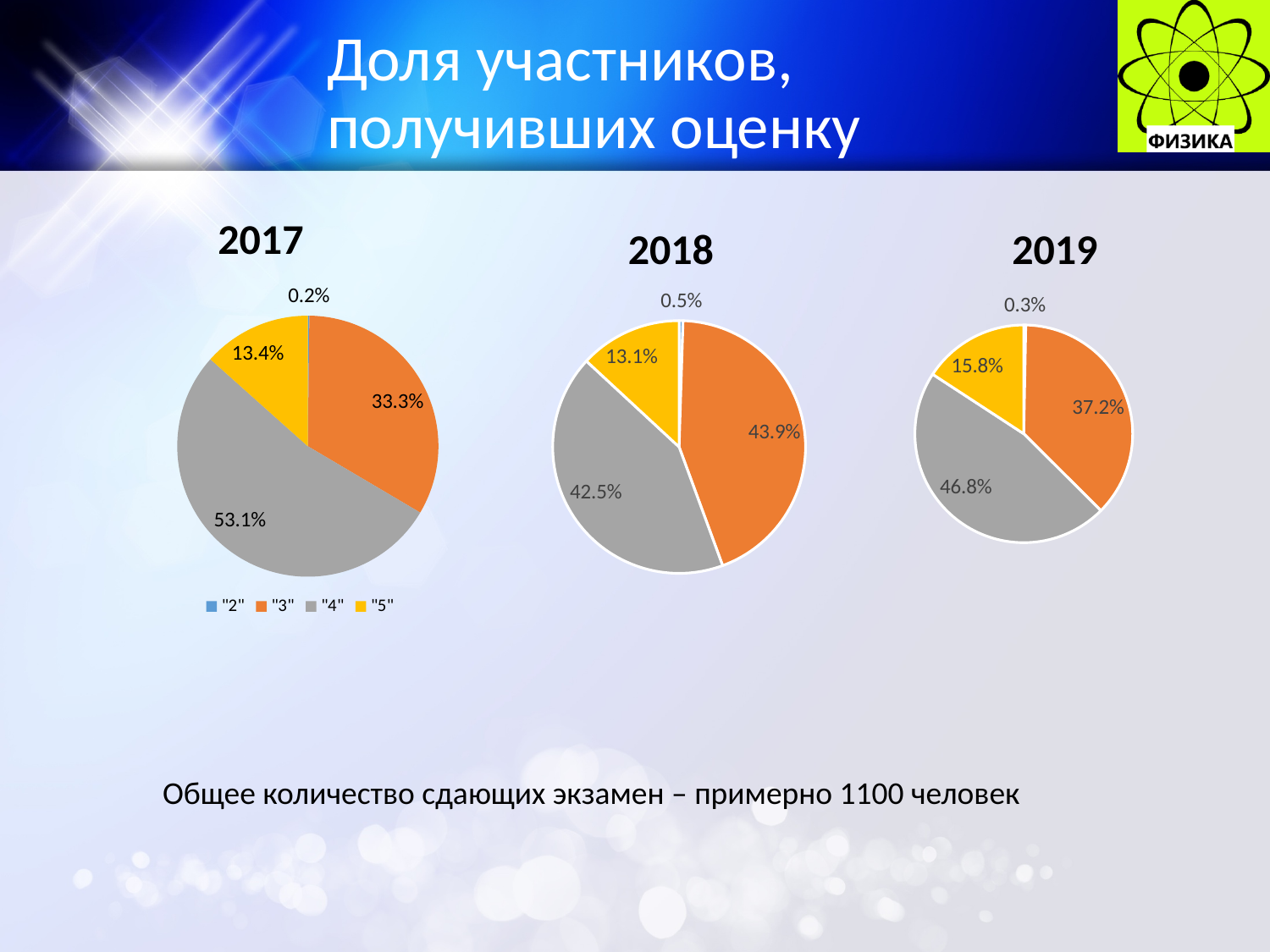
In the 2018 pie chart, which grade has the largest share? "3" How many entries does the legend under the 2017 pie chart list? 4 In the 2017 pie chart, which grade has the largest share? "4" In the 2017 pie chart, which is larger: the share for grade "3" or the share for grade "5"? "3" What kind of charts are shown on the slide? Pie charts How many slices does each pie chart have? 4 In the 2018 pie chart, which grade has the smallest share? "2" In the 2019 pie chart, what share of participants received the grade "5"? 15.8% In the 2019 pie chart, what is the difference between the shares for grade "4" and grade "3"? 9.6% In the 2017 pie chart, what share of participants received the grade "4"? 53.1% In the 2018 pie chart, what share of participants received the grade "3"? 43.9% In the 2019 pie chart, what share of participants received the grade "2"? 0.3%